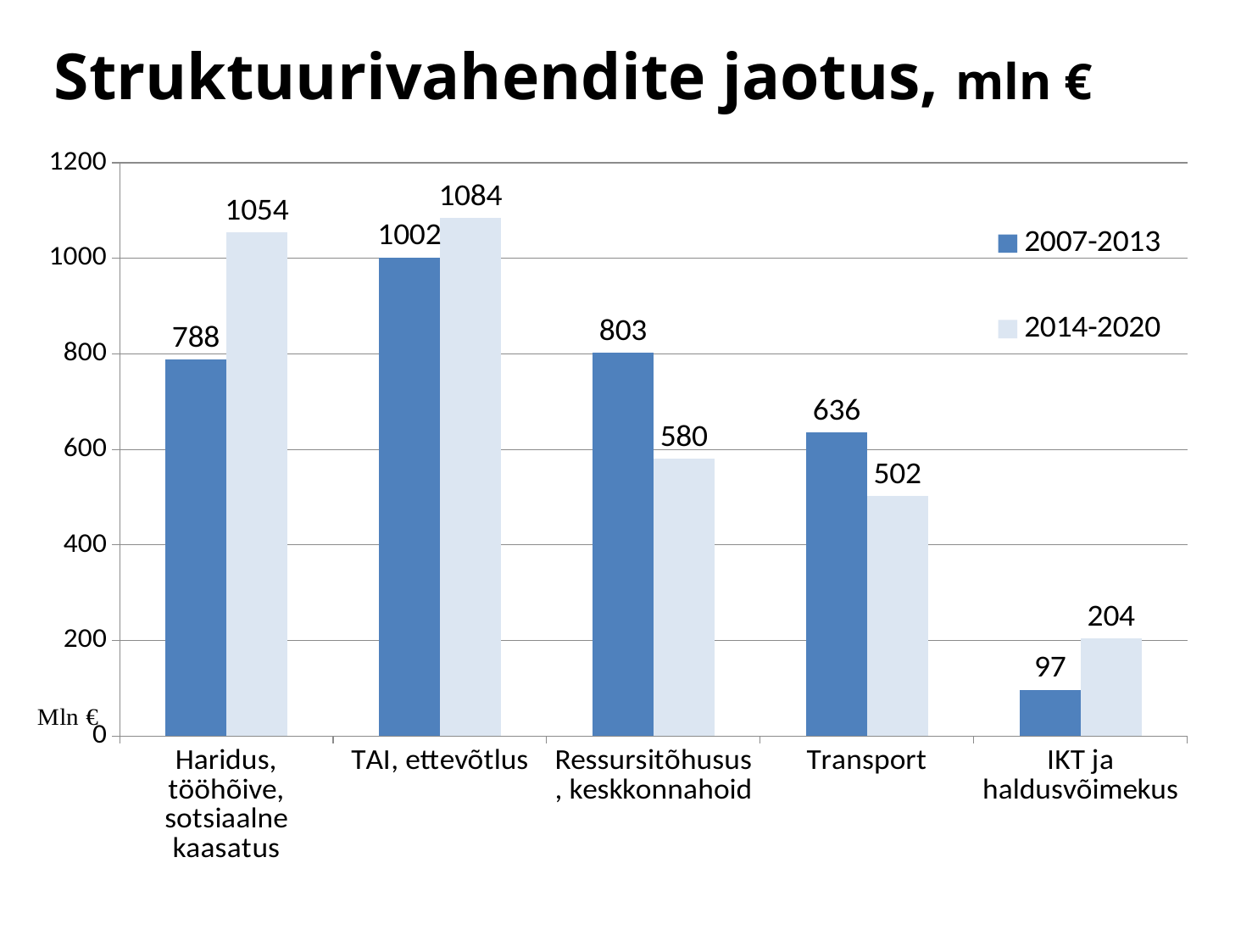
What is the title of the chart? Struktuurivahendite jaotus, mln € Which is larger for Ressursitõhusus, keskkonnahoid: the 2007-2013 value or the 2014-2020 value? 2007-2013 What kind of chart is shown on the slide? bar chart What is the value for IKT ja haldusvõimekus in the 2007-2013 series? 97 What is the value for TAI, ettevõtlus in the 2014-2020 series? 1084 What is the value for Transport in the 2007-2013 series? 636 Which category has the highest value in the 2014-2020 series? TAI, ettevõtlus Which category has the lowest value in the 2007-2013 series? IKT ja haldusvõimekus Is the 2014-2020 value for Transport greater or less than 600? less What is the difference between the 2014-2020 and 2007-2013 values for Haridus, tööhõive, sotsiaalne kaasatus? 266 How many series does the legend list? 2 How many categories are shown on the x axis? 5